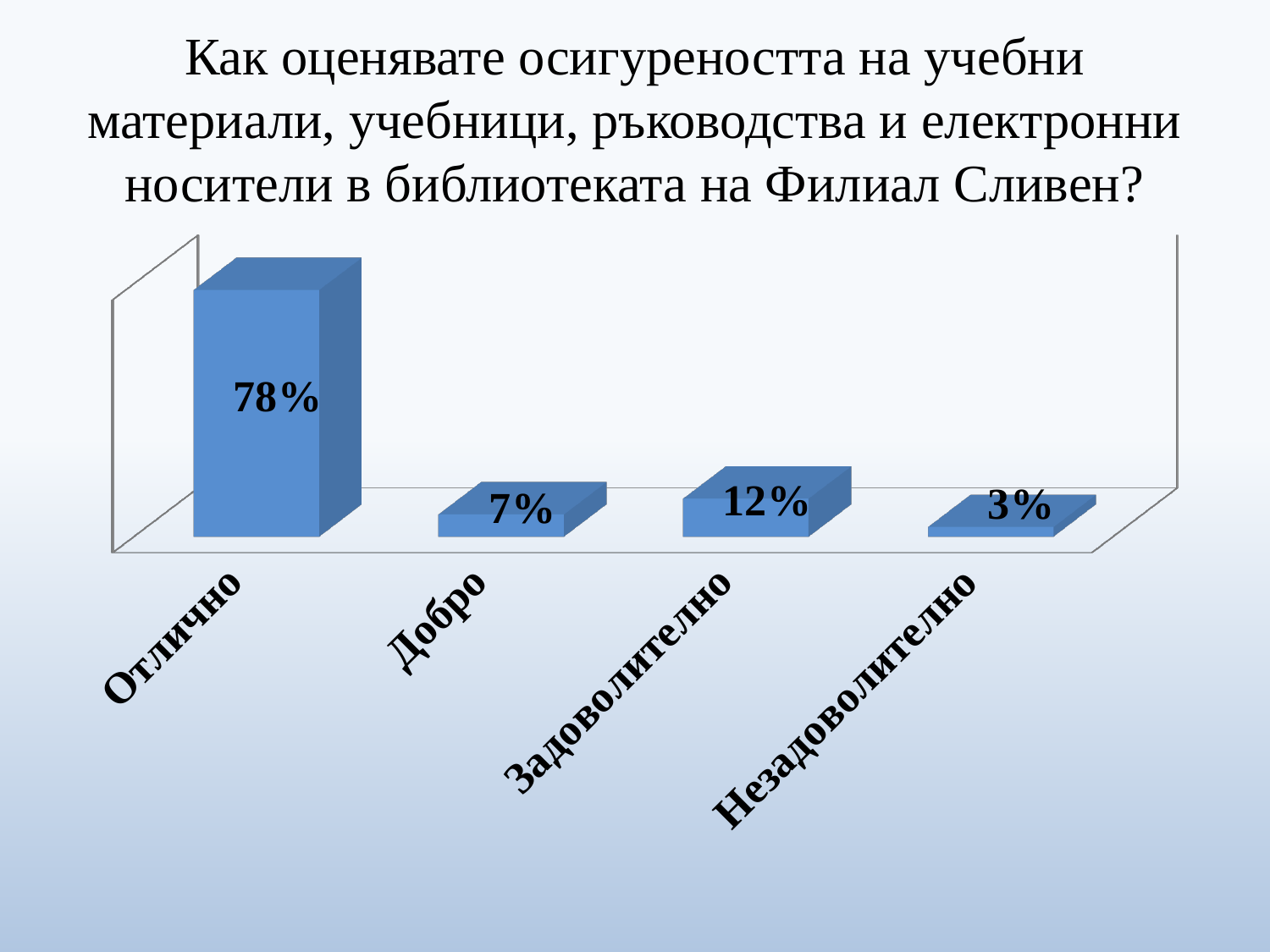
Which category has the highest value? Отлично What is the value for Незадоволително? 3% Which category has the lowest value? Незадоволително What is the difference between the values for Отлично and Задоволително? 66% What is the difference between the values for Задоволително and Добро? 5% What is the value for Отлично? 78% What is the value for Добро? 7% Which is larger, the value for Добро or the value for Задоволително? Задоволително How many categories are shown on the chart? 4 What is the value for Задоволително? 12% What kind of chart is shown on the slide? bar chart What colour are the bars in the chart? blue